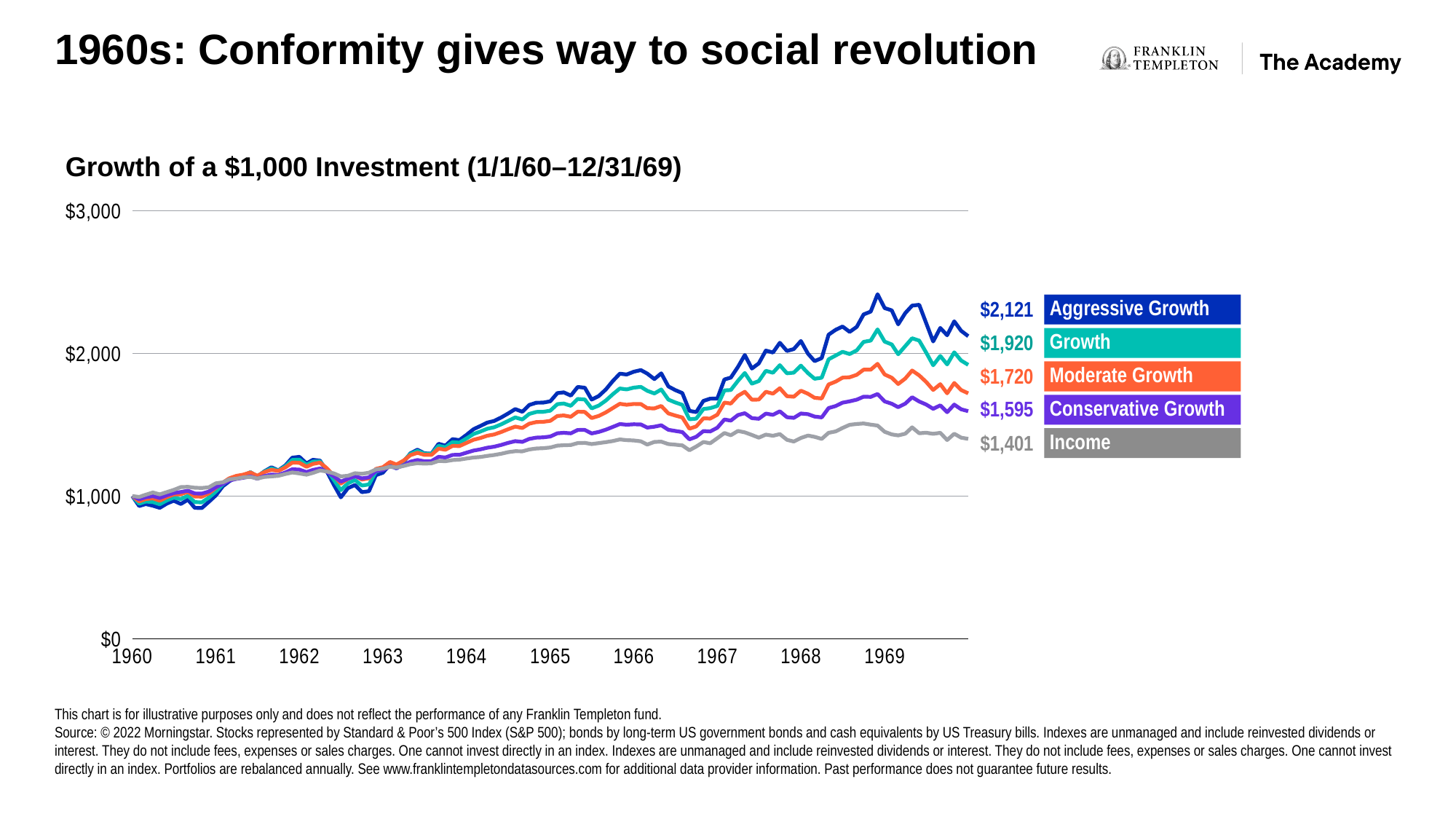
What is the difference between the ending values of Growth and Conservative Growth? $325 What is the ending value of the Moderate Growth portfolio? $1,720 Does the Aggressive Growth line generally rise or fall from 1960 to 1969? rise Which portfolio has the lowest ending value? Income What is the difference between the ending values of Aggressive Growth and Income? $720 What is the ending value of the Income portfolio? $1,401 Which portfolio has the highest ending value? Aggressive Growth What type of chart is shown on the slide? line chart Is the ending value of the Conservative Growth portfolio greater or less than $2,000? less Which has a higher ending value, Growth or Moderate Growth? Growth How many portfolios are shown in the legend? 5 What is the ending value of the Aggressive Growth portfolio? $2,121